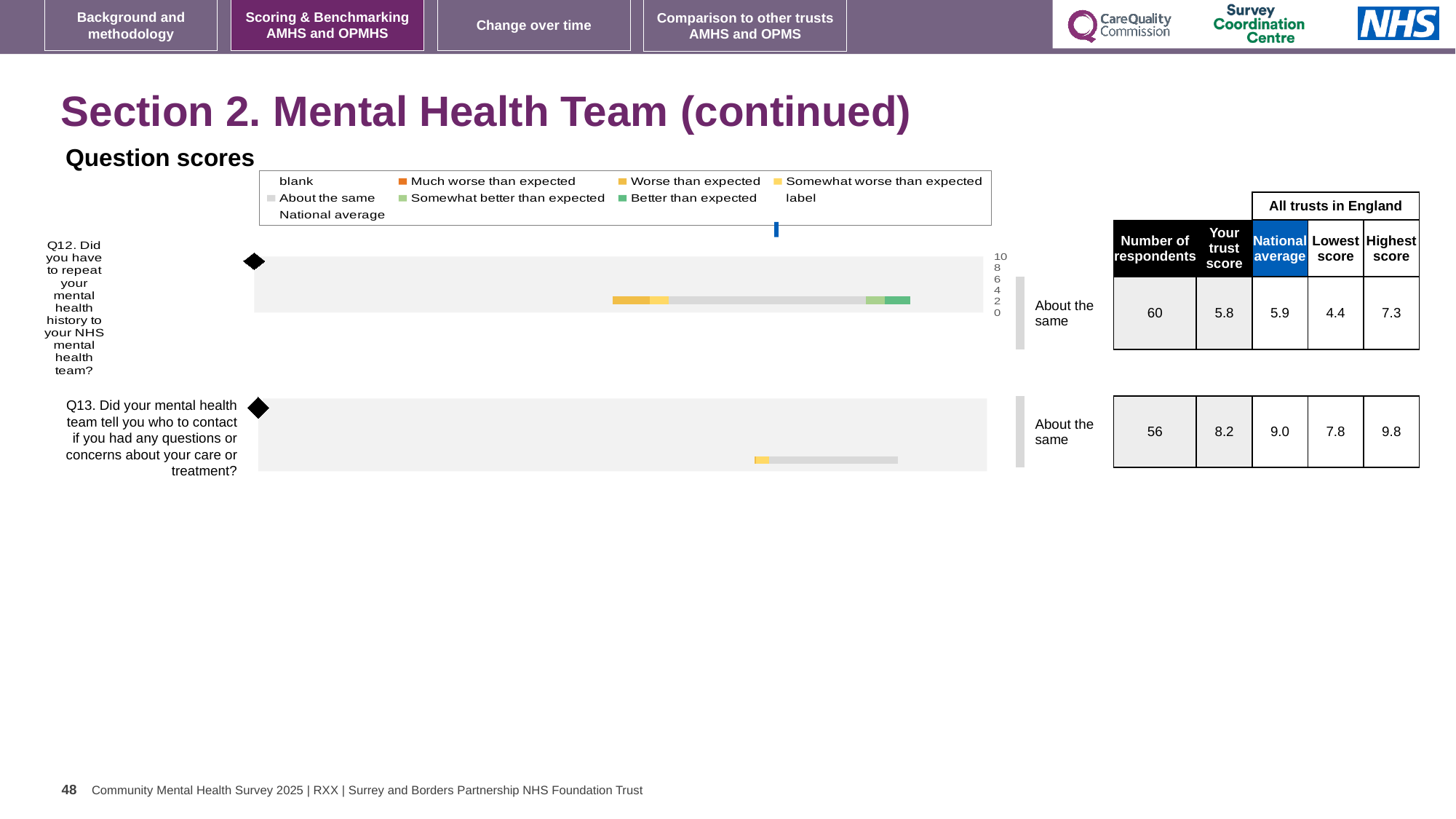
How many respondents answered Q12? 60 For Q13 (who to contact with questions or concerns), what is the trust score shown? 8.2 For Q12 (repeating your mental health history), what is the trust score shown? 5.8 For Q12, is the trust score higher or lower than the national average? lower What benchmark category label is shown next to the Q13 chart? About the same For Q13, what is the difference between the highest score (9.8) and the lowest score (7.8) among all trusts? 2.0 For Q12 (repeating your mental health history), what is the national average score? 5.9 For Q12, what is the difference between the highest score (7.3) and the lowest score (4.4) among all trusts? 2.9 For Q13 (who to contact with questions or concerns), what is the highest score among all trusts in England? 9.8 How many questions (Q12 and Q13) have a score chart on this slide? 2 Which question has the higher trust score, Q12 or Q13? Q13 What kind of chart is used to show the question scores for Q12 and Q13? bar chart